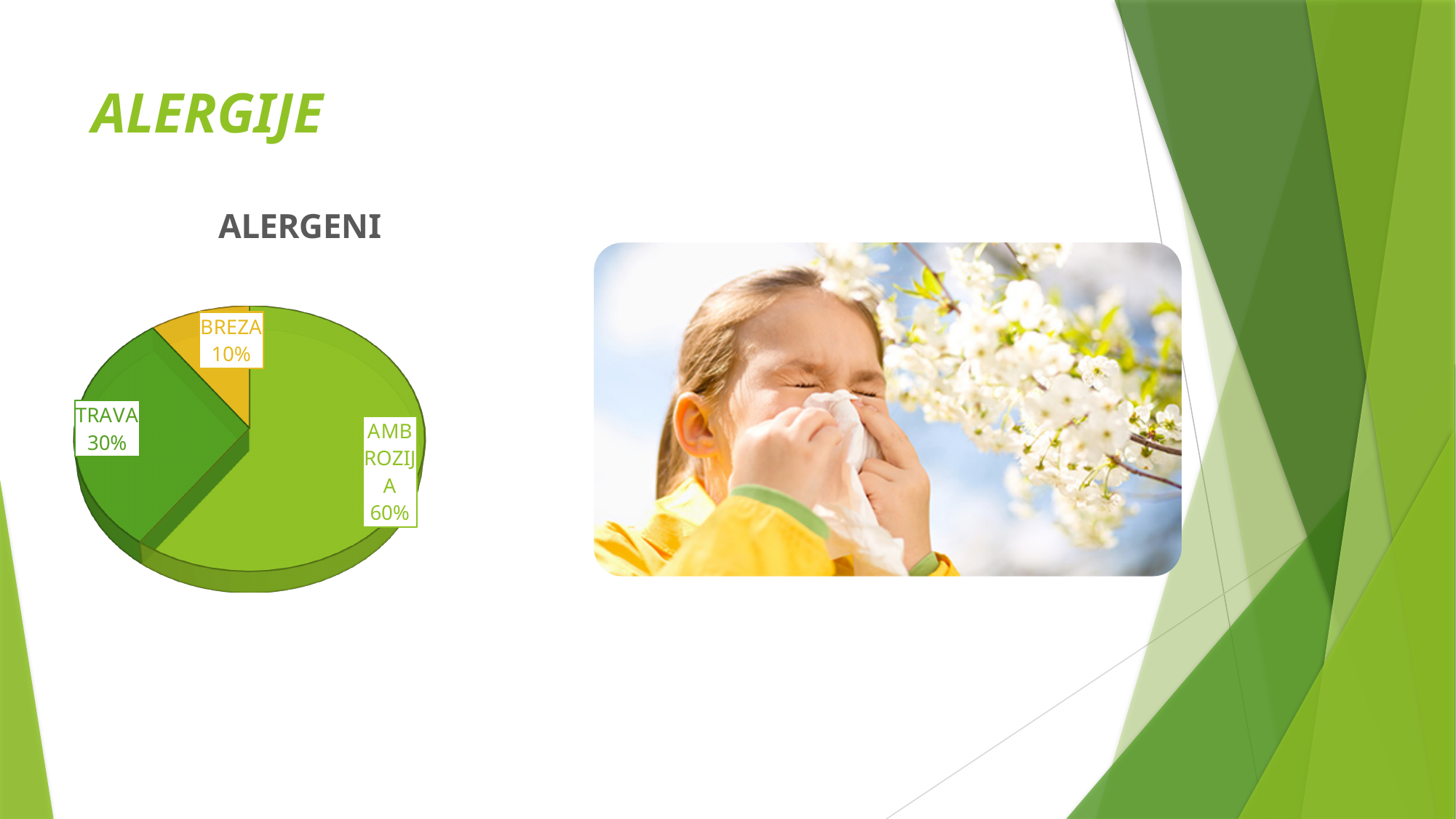
What share of the pie does BREZA take? 10% What is the title of the chart? ALERGENI How many categories are shown in the pie chart? 3 What share of the pie does AMBROZIJA take? 60% What share of the pie does TRAVA take? 30% What colour is the BREZA slice? Yellow What type of chart is shown on the slide? Pie chart Which category has the smallest slice of the pie? BREZA What is the difference between the shares of AMBROZIJA and TRAVA? 30% Which is larger, the share for TRAVA or the share for BREZA? TRAVA Which category has the largest slice of the pie? AMBROZIJA What is the difference between the shares of TRAVA and BREZA? 20%